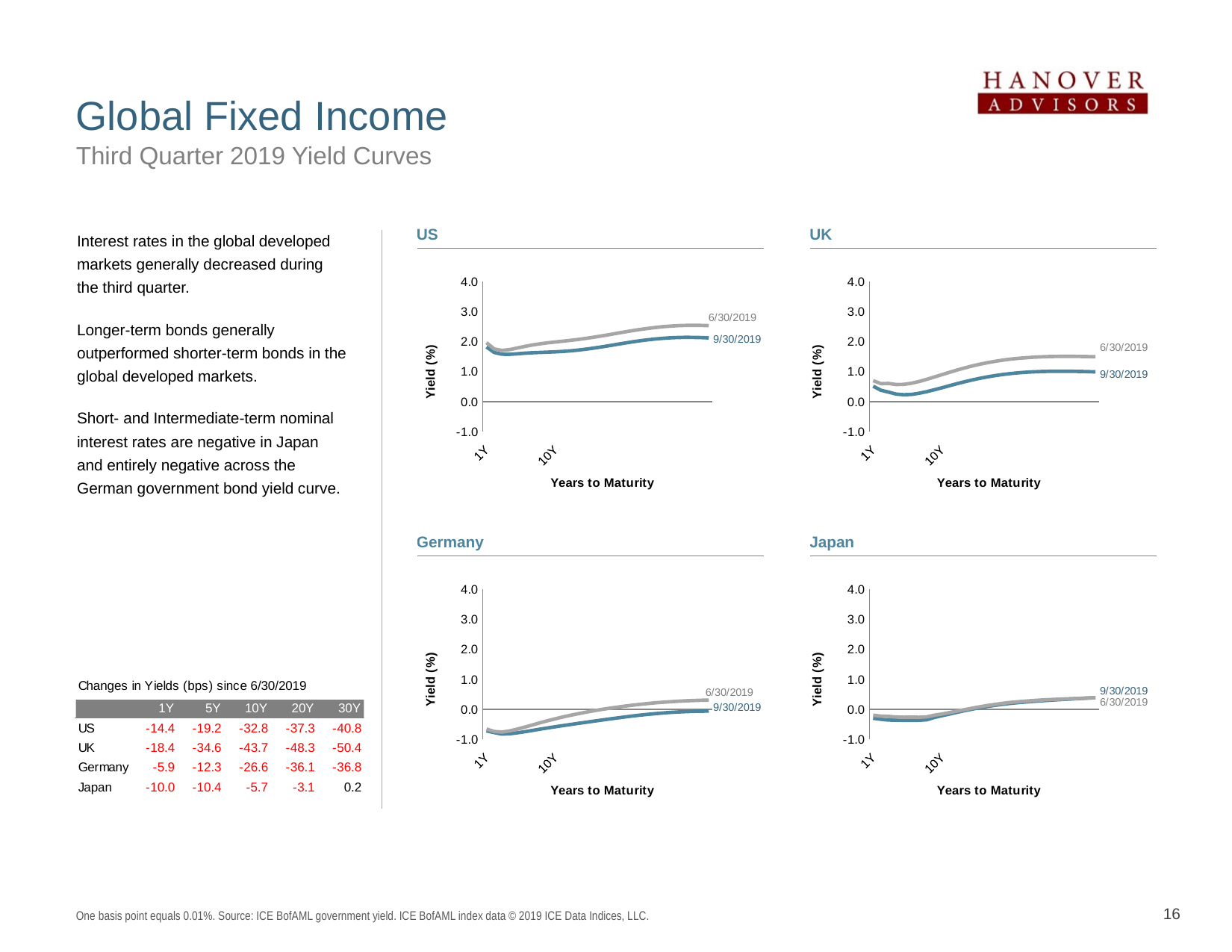
What is the x-axis title of the UK chart? Years to Maturity What kind of chart is the US chart? line chart What is the y-axis title of the Japan chart? Yield (%) In the Japan chart, is the 6/30/2019 yield at 1Y greater or less than 0.0? less In the UK chart, is the 9/30/2019 yield at 1Y greater or less than 1.0? less How many yield curve charts are on the slide? 4 In the US chart, which series is higher at 10Y, 6/30/2019 or 9/30/2019? 6/30/2019 In the UK chart, which series is higher at 10Y, 6/30/2019 or 9/30/2019? 6/30/2019 In the Germany chart, is the 9/30/2019 yield at 1Y greater or less than 0.0? less In the Germany chart, does the 9/30/2019 curve generally rise or fall from 1Y to 10Y? rise How many series does the US chart show? 2